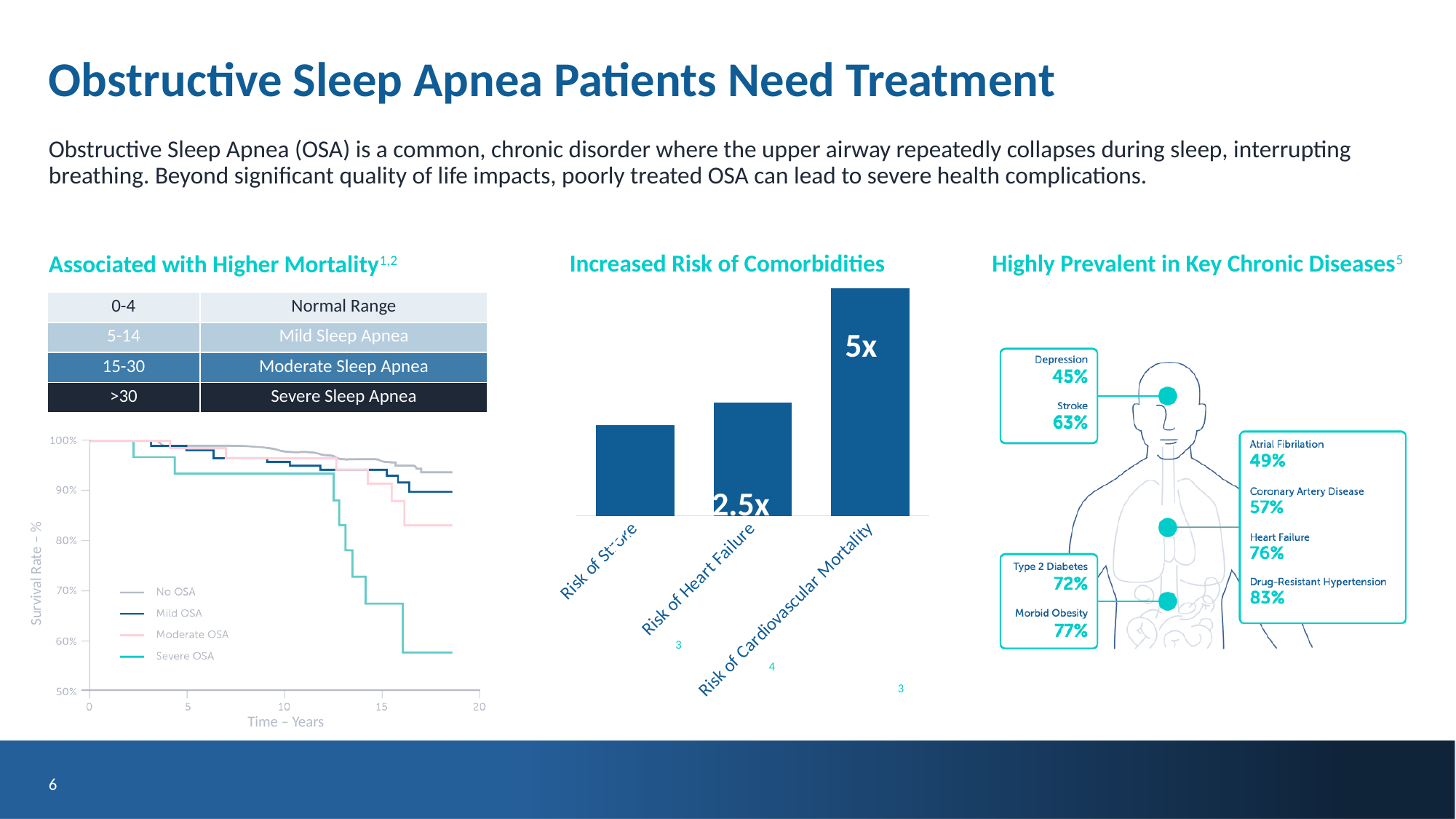
In the survival rate chart, which series has the lowest survival rate at the end of the time period? Severe OSA In the 'Increased Risk of Comorbidities' chart, which category has the highest value? Risk of Cardiovascular Mortality How many bars are in the 'Increased Risk of Comorbidities' chart? 3 In the 'Increased Risk of Comorbidities' chart, which category has the lowest value? Risk of Stroke What kind of chart is the 'Increased Risk of Comorbidities' chart? bar chart How many series does the legend of the survival rate chart list? 4 In the 'Increased Risk of Comorbidities' chart, which is larger: Risk of Heart Failure or Risk of Cardiovascular Mortality? Risk of Cardiovascular Mortality What kind of chart is the survival rate chart under 'Associated with Higher Mortality'? line chart In the survival rate chart, is the survival rate for Severe OSA at 18 years greater or less than 70%? less In the 'Increased Risk of Comorbidities' chart, what is the value for Risk of Cardiovascular Mortality? 5x In the 'Increased Risk of Comorbidities' chart, what is the value for Risk of Heart Failure? 2.5x In the survival rate chart, do the survival rates rise or fall as time in years increases? fall